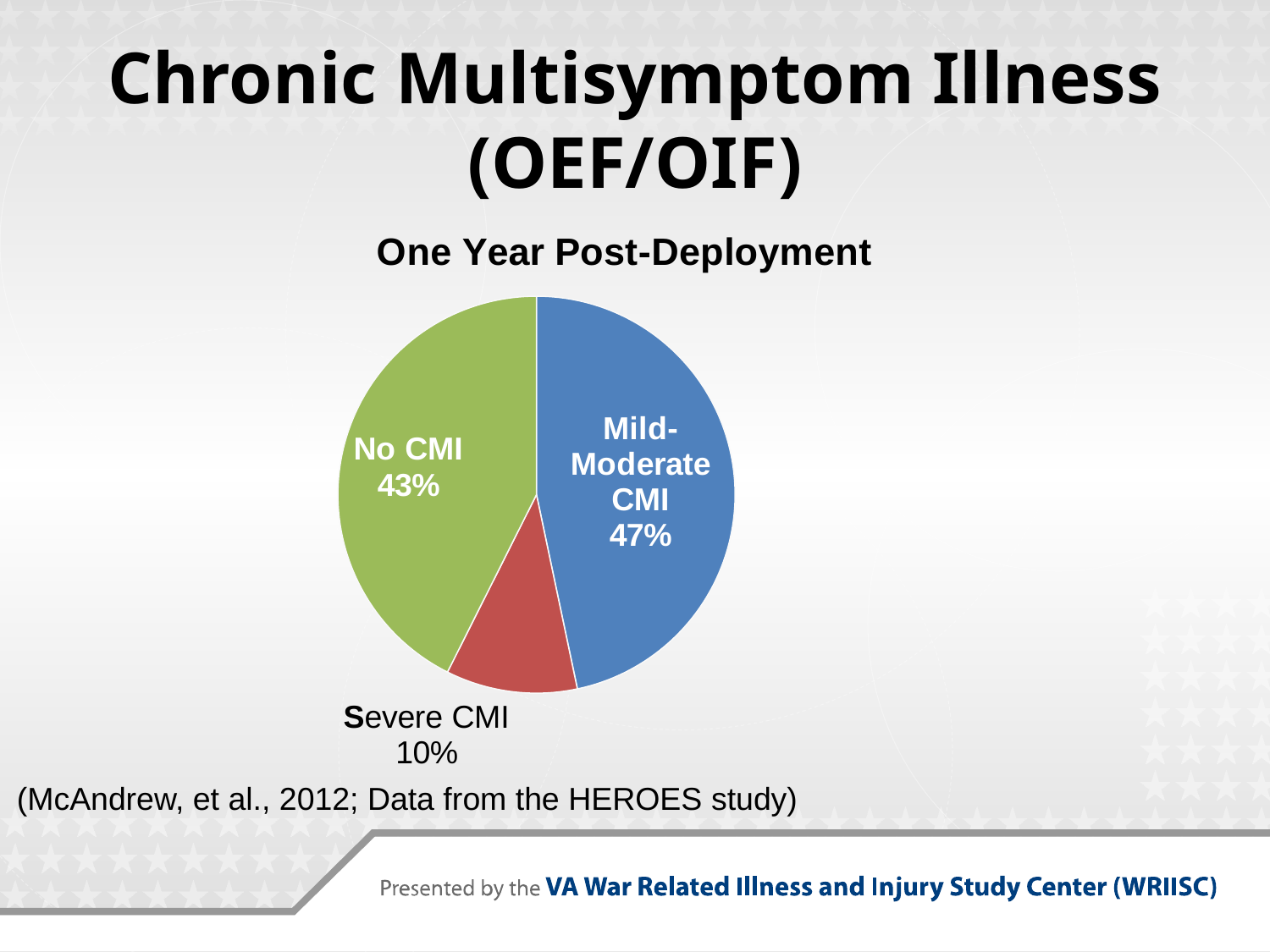
What percentage of the pie is labelled Severe CMI? 10% What is the difference in percentage points between the No CMI slice and the Severe CMI slice? 33 What is the difference in percentage points between the Mild-Moderate CMI slice and the No CMI slice? 4 Which slice of the pie is the smallest? Severe CMI How many slices does the pie chart have? 3 What type of chart is shown on the slide? pie chart What is the chart's title? One Year Post-Deployment What percentage of the pie is labelled No CMI? 43% Which is larger, the No CMI slice or the Severe CMI slice? No CMI What colour is the Severe CMI slice? red Which slice of the pie is the largest? Mild-Moderate CMI What percentage of the pie is labelled Mild-Moderate CMI? 47%